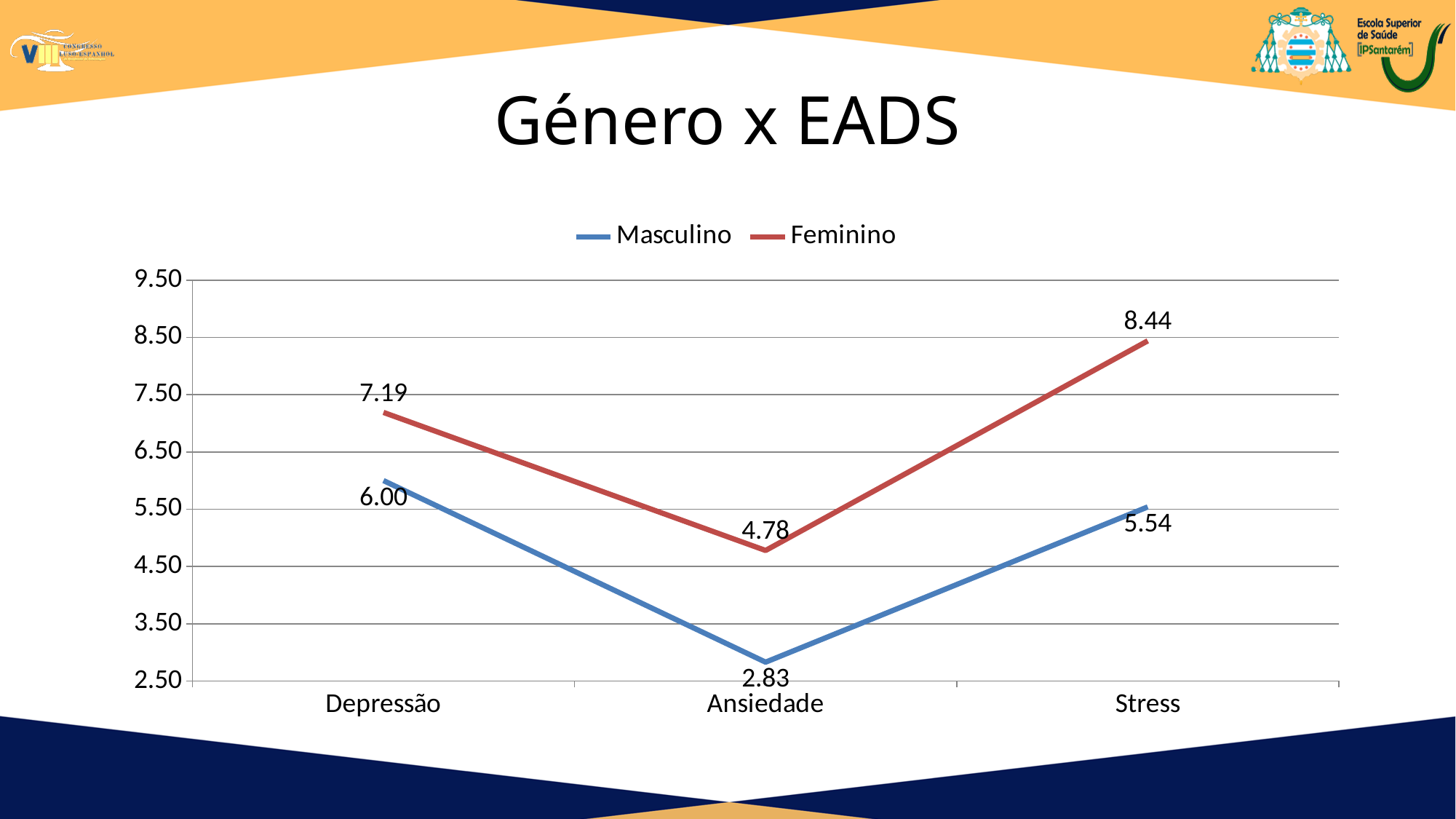
What is the Masculino value for Ansiedade? 2.83 What is the title of the slide? Género x EADS What is the difference between the Feminino and Masculino values for Stress? 2.90 For which category is the Feminino value highest? Stress How many categories are shown on the x axis? 3 What is the Feminino value for Ansiedade? 4.78 What kind of chart is shown on the slide? Line chart Which is larger for Depressão, the Masculino value or the Feminino value? Feminino What is the Masculino value for Depressão? 6.00 How many series does the legend list? 2 For which category is the Masculino value lowest? Ansiedade What is the Feminino value for Stress? 8.44